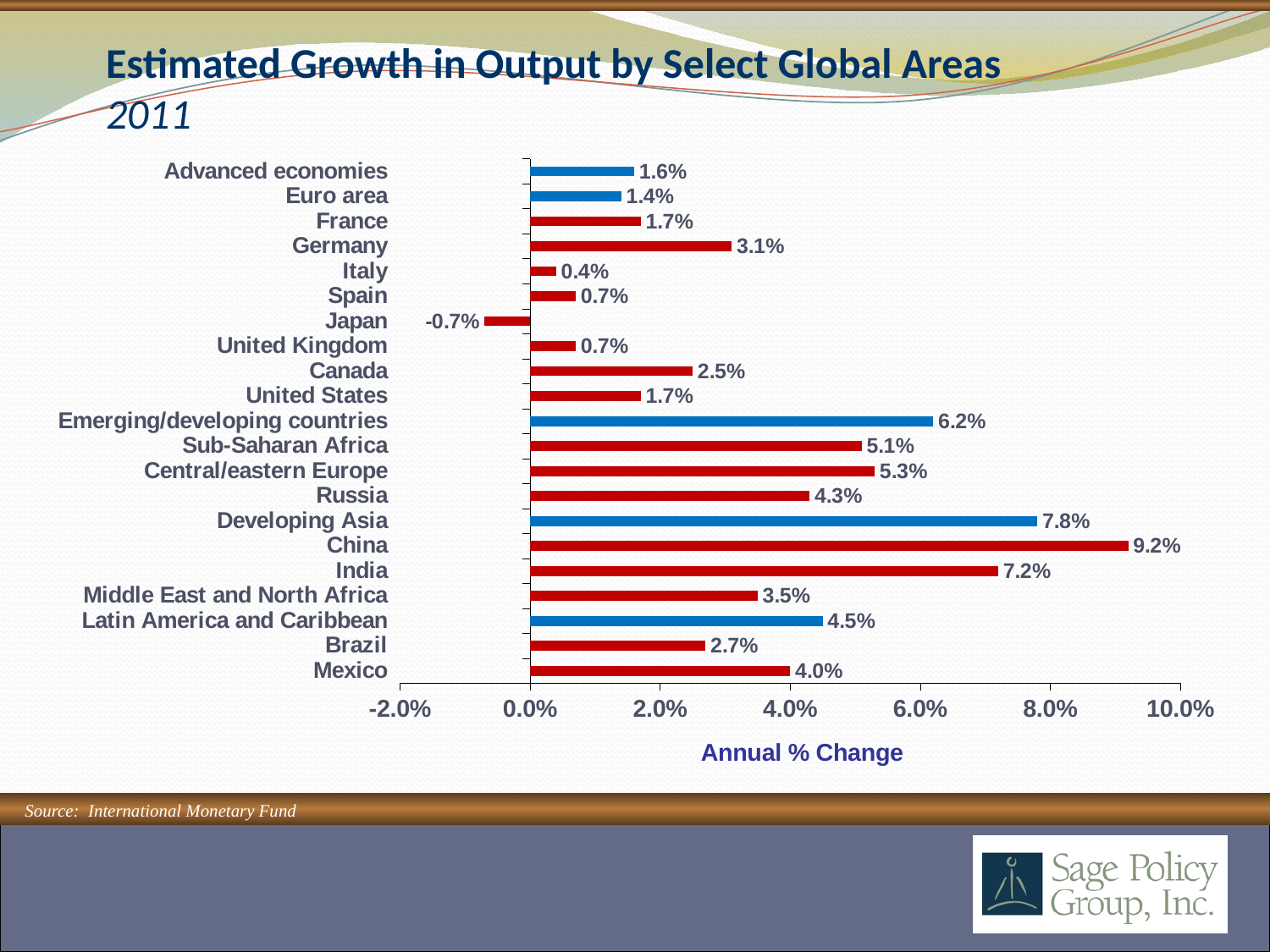
What is the source cited for the chart data? International Monetary Fund Which has a higher estimated growth in output, Germany or Canada? Germany How many areas are shown in the chart? 21 What is the estimated growth in output for China? 9.2% What kind of chart is shown on the slide? Bar chart What is the difference between the estimated growth for India and Developing Asia? 0.6% What is the estimated growth in output for Emerging/developing countries? 6.2% Is the value for Russia greater or less than 4.0%? greater What is the label of the horizontal axis? Annual % Change Which area has the lowest estimated growth in output? Japan Which area has the highest estimated growth in output? China What is the estimated growth in output for Japan? -0.7%